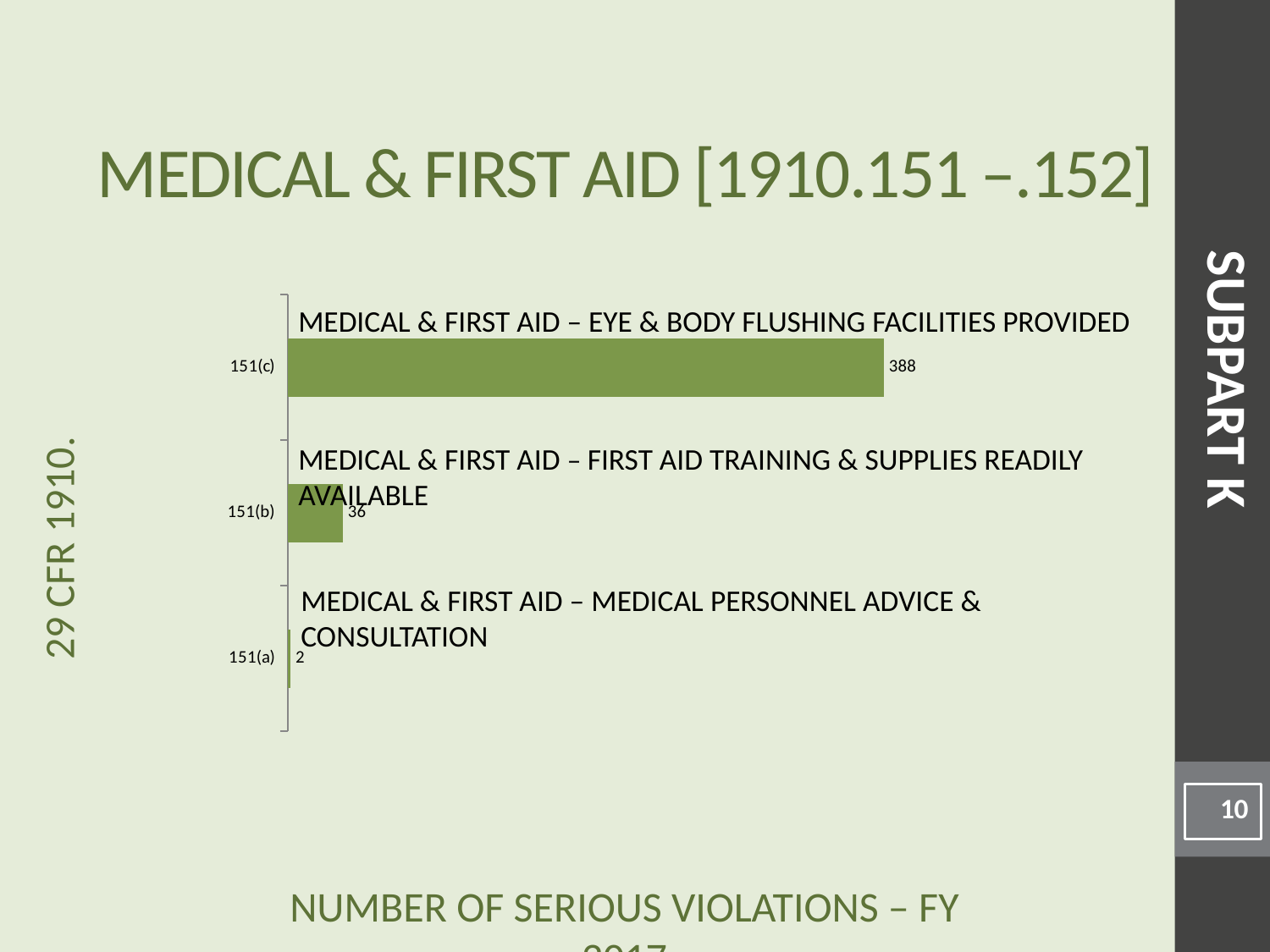
What is the number of serious violations for 151(c)? 388 What is the number of serious violations for 151(b)? 36 What is the difference between the values for 151(c) and 151(b)? 352 What kind of chart is shown on the slide? Bar chart Which has more serious violations, 151(b) or 151(a)? 151(b) What is the number of serious violations for 151(a)? 2 What is the total number of serious violations across all three categories? 426 What is the difference between the values for 151(b) and 151(a)? 34 Which category has the lowest number of serious violations? 151(a) Which category is labelled 'MEDICAL & FIRST AID – EYE & BODY FLUSHING FACILITIES PROVIDED'? 151(c) How many categories are shown in the chart? 3 Which category has the highest number of serious violations? 151(c)